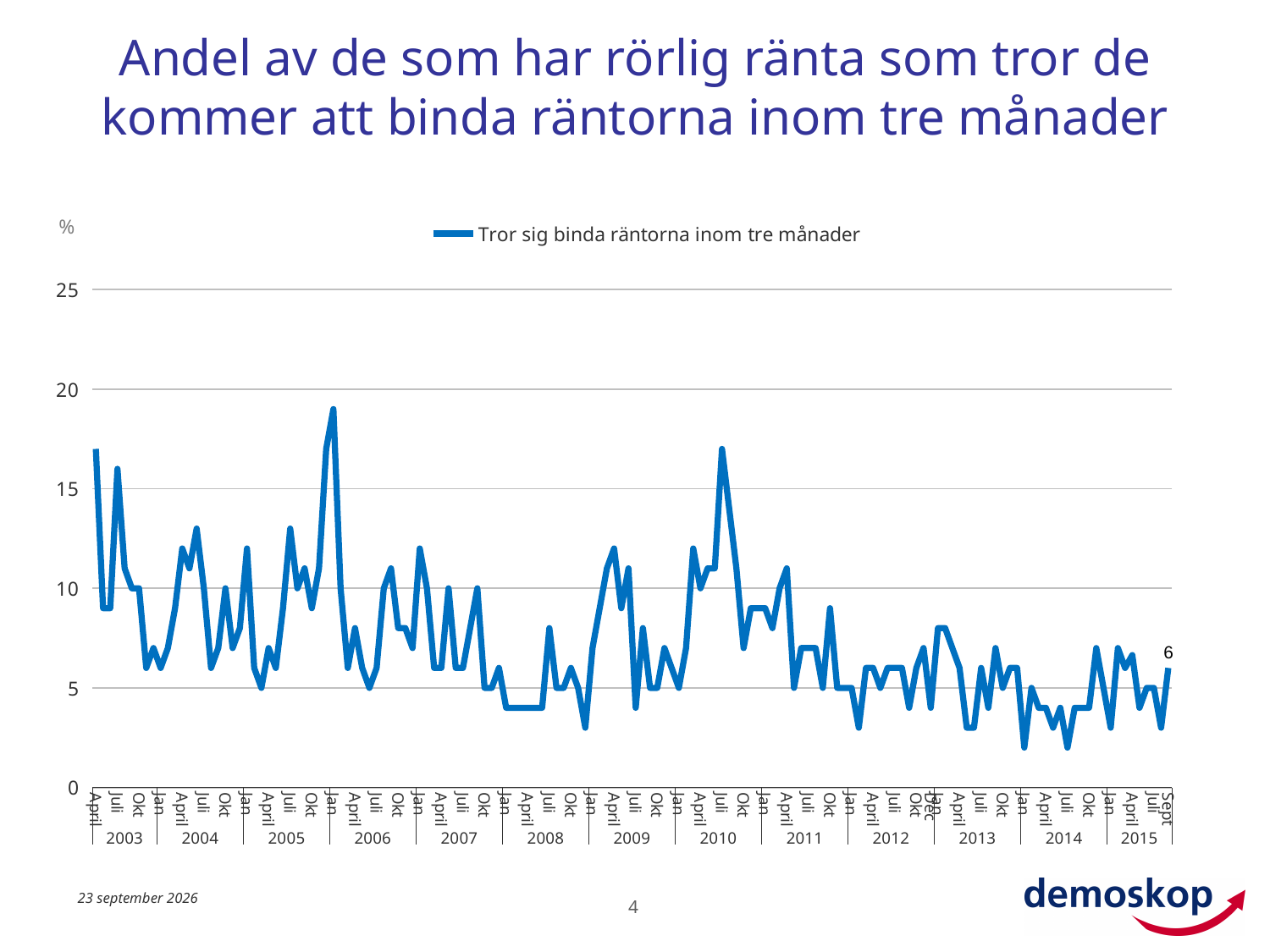
What is the legend entry for the plotted series? Tror sig binda räntorna inom tre månader Is the value for Sept 2015 greater or less than 5? greater Is the peak value of the line around Jan 2006 greater or less than 15? greater Overall, do the values rise or fall from 2003 to 2015? fall What kind of chart is shown on the slide? line chart How many years are labelled on the x axis? 13 Is the value for Juli 2010 greater or less than 15? greater What is the last data-labelled value on the line, at Sept 2015? 6 What is the highest value shown on the y axis? 25 How many series does the legend list? 1